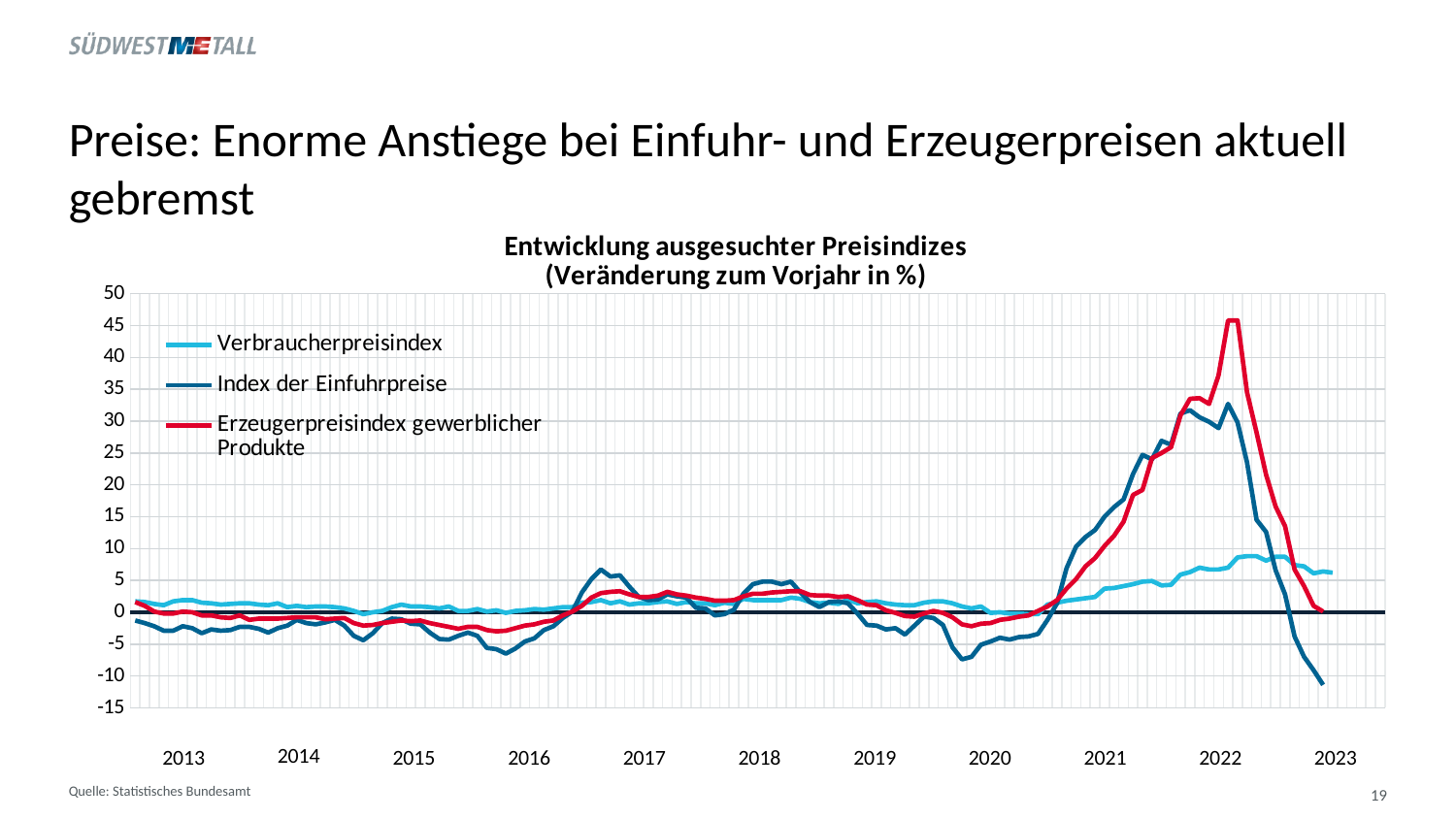
Is the peak value of the Verbraucherpreisindex greater or less than 10? less Is the peak value of the Index der Einfuhrpreise greater or less than 30? greater Which colour is used for the Verbraucherpreisindex line? light blue At the end of the series in 2023, which is higher: the Verbraucherpreisindex or the Index der Einfuhrpreise? Verbraucherpreisindex How many series does the legend list? 3 What is the highest value shown on the y axis? 50 Which series reaches the highest peak in the chart? Erzeugerpreisindex gewerblicher Produkte Is the peak value of the Erzeugerpreisindex gewerblicher Produkte greater or less than 40? greater What is the title of the chart? Entwicklung ausgesuchter Preisindizes (Veränderung zum Vorjahr in %) Does the Erzeugerpreisindex gewerblicher Produkte rise or fall between its 2022 peak and the end of the series in 2023? fall What kind of chart is shown on the slide? line chart